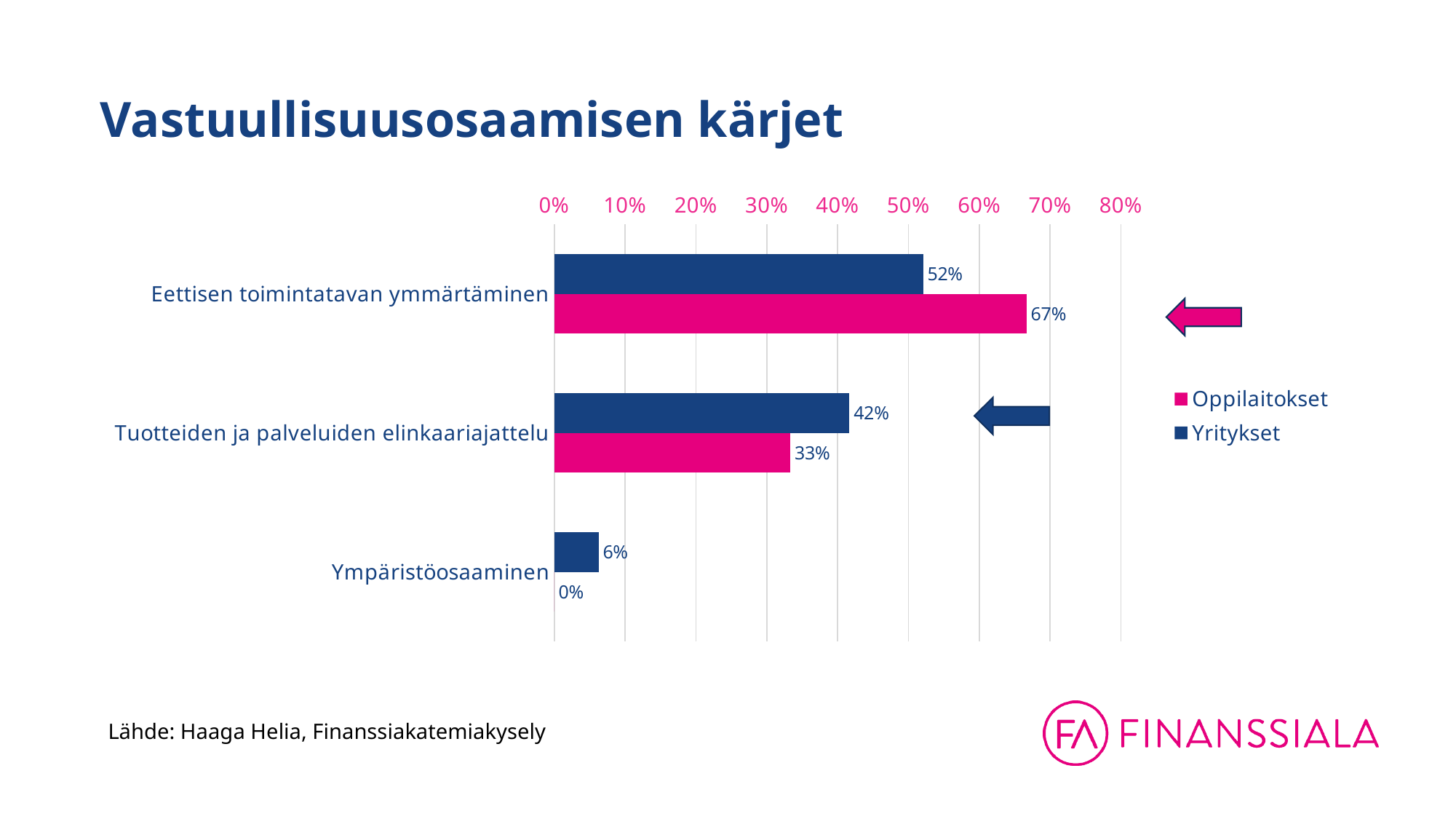
What is the Yritykset value for Ympäristöosaaminen? 6% What is the Oppilaitokset value for Eettisen toimintatavan ymmärtäminen? 67% What is the Oppilaitokset value for Tuotteiden ja palveluiden elinkaariajattelu? 33% How many series does the legend list? 2 How many categories are shown on the chart? 3 Which colour represents the Oppilaitokset series? Pink For Tuotteiden ja palveluiden elinkaariajattelu, which series has the larger value, Oppilaitokset or Yritykset? Yritykset What kind of chart is shown on the slide? Bar chart Which category has the lowest Oppilaitokset value? Ympäristöosaaminen What is the difference between the Oppilaitokset and Yritykset values for Eettisen toimintatavan ymmärtäminen? 15% What is the Yritykset value for Eettisen toimintatavan ymmärtäminen? 52% Which category has the highest Yritykset value? Eettisen toimintatavan ymmärtäminen